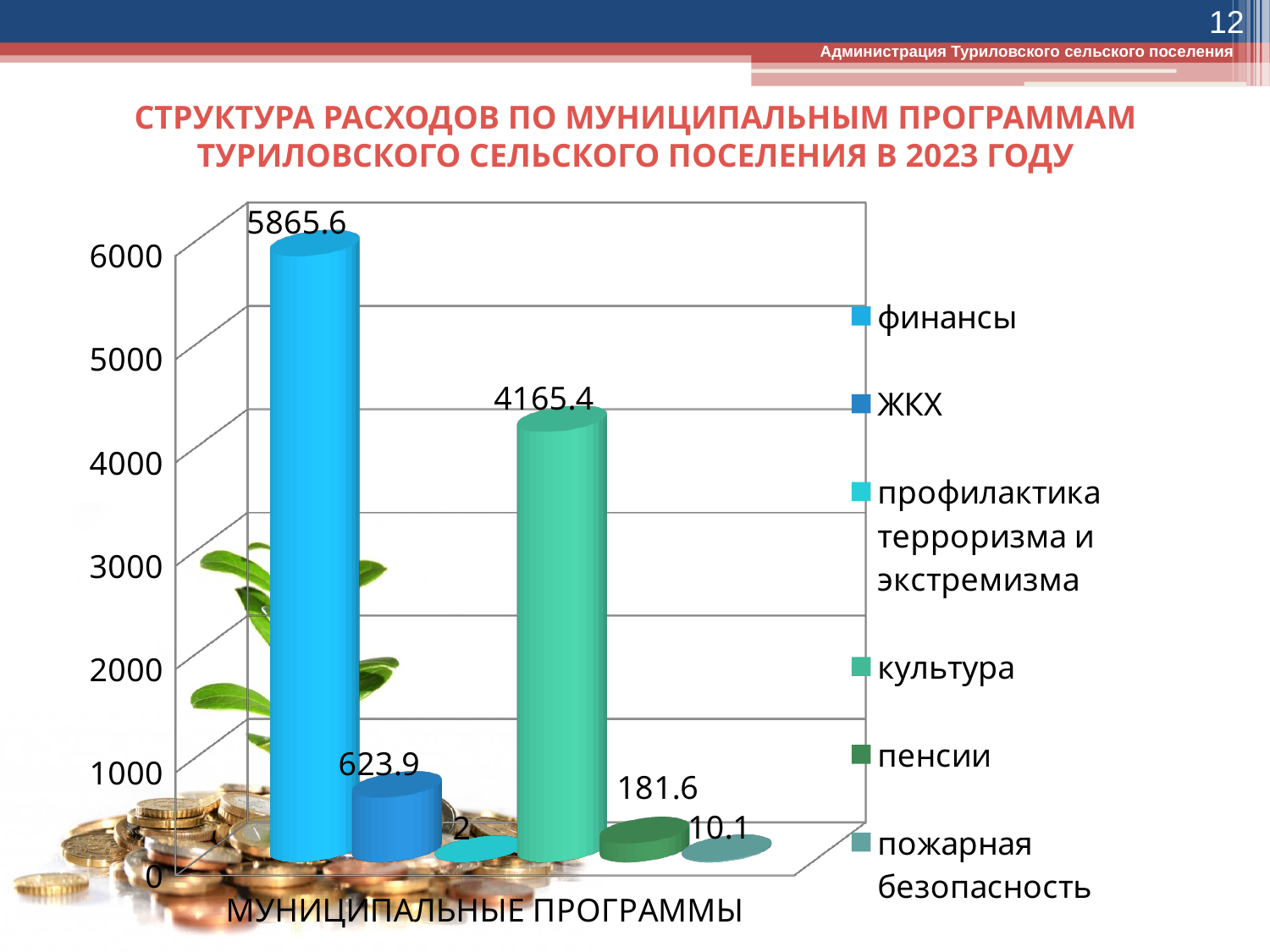
What is the value for ЖКХ? 623.9 Which series has the lowest value? профилактика терроризма и экстремизма What is the value for культура? 4165.4 Is the value for культура greater or less than 4000? greater What is the value for пенсии? 181.6 Which series has the highest value? финансы How many series does the legend list? 6 What is the value for пожарная безопасность? 10.1 What is the difference between the values for финансы and культура? 1700.2 Which is larger, the value for ЖКХ or the value for пенсии? ЖКХ What kind of chart is shown on the slide? bar chart What is the value for финансы? 5865.6